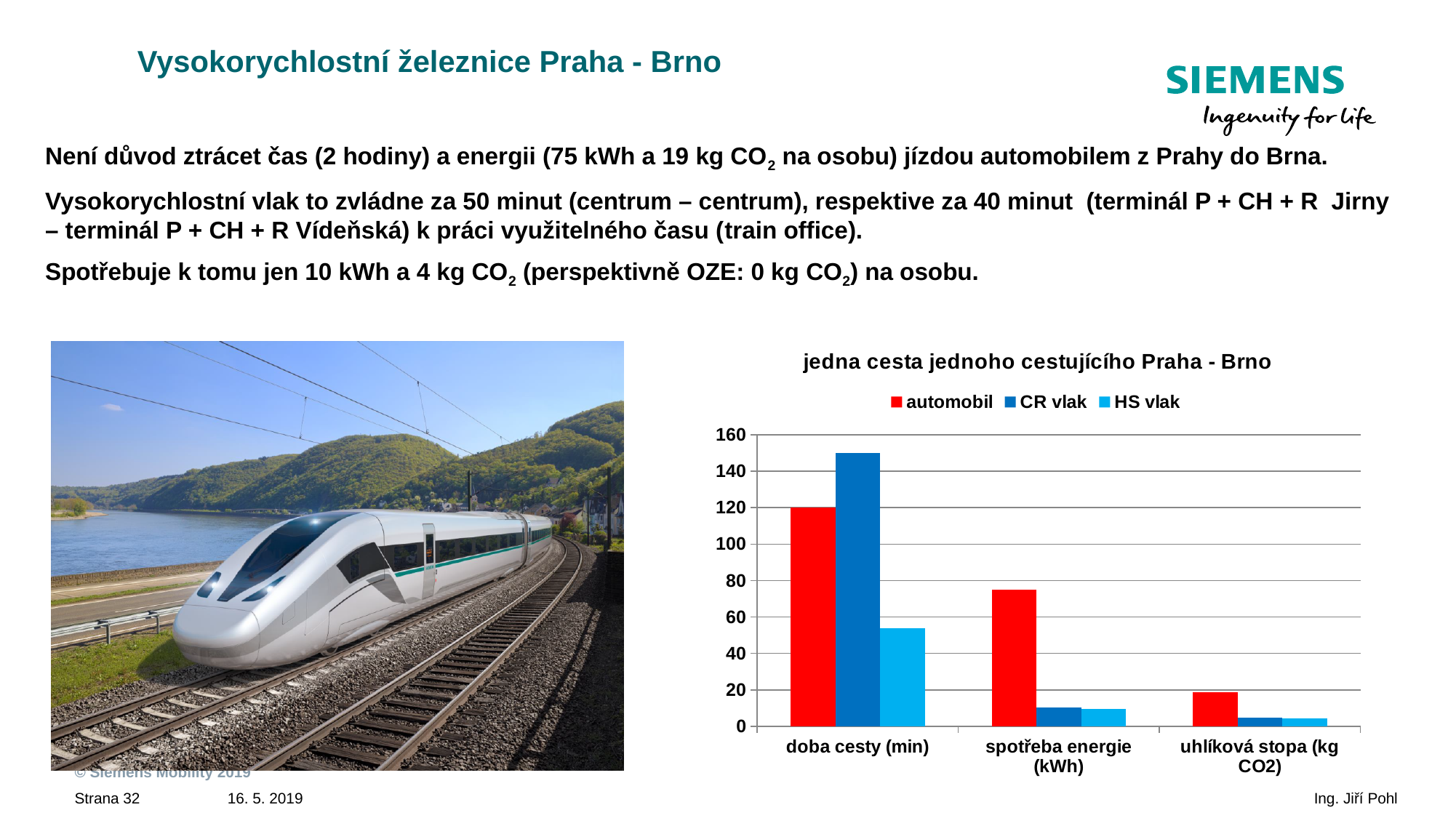
Is the value for automobil in the category uhlíková stopa (kg CO2) greater or less than 10? greater Which series has the highest value in the category uhlíková stopa (kg CO2)? automobil What is the value for automobil in the category doba cesty (min)? 120 Is the value for HS vlak in the category doba cesty (min) greater or less than 60? less Which series has the highest value in the category doba cesty (min)? CR vlak Is the value for CR vlak in the category doba cesty (min) greater or less than 140? greater How many series does the legend of the chart list? 3 What kind of chart is shown on the slide? bar chart What is the title of the chart? jedna cesta jednoho cestujícího Praha - Brno In the category spotřeba energie (kWh), which is larger: automobil or HS vlak? automobil How many categories are shown on the x axis of the chart? 3